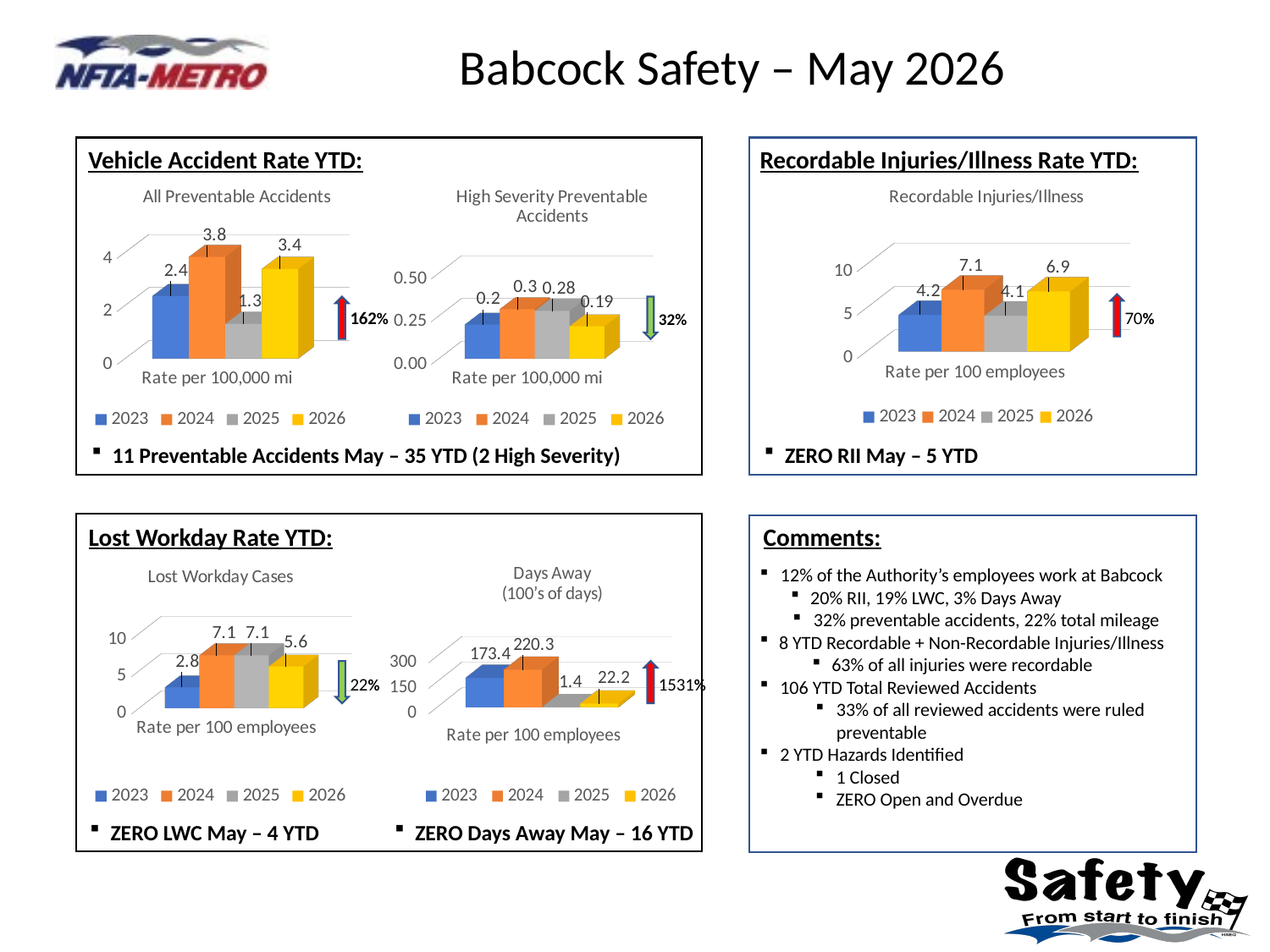
How many series does the legend of the Lost Workday Cases chart list? 4 In the All Preventable Accidents chart, what is the difference between the 2024 and 2025 values? 2.5 In the High Severity Preventable Accidents chart, what is the value for 2025? 0.28 In the High Severity Preventable Accidents chart, which year has the lowest value? 2026 In the All Preventable Accidents chart, what is the value for 2026? 3.4 In the All Preventable Accidents chart, which year has the highest rate? 2024 In the Days Away chart, what is the difference between the 2026 and 2025 values? 20.8 In the Days Away chart, what is the value for 2024? 220.3 In the Lost Workday Cases chart, which year has the lowest value? 2023 In the Recordable Injuries/Illness chart, which is larger, the value for 2023 or the value for 2026? 2026 In the Recordable Injuries/Illness chart, what is the value for 2024? 7.1 In the Lost Workday Cases chart, what is the value for 2026? 5.6